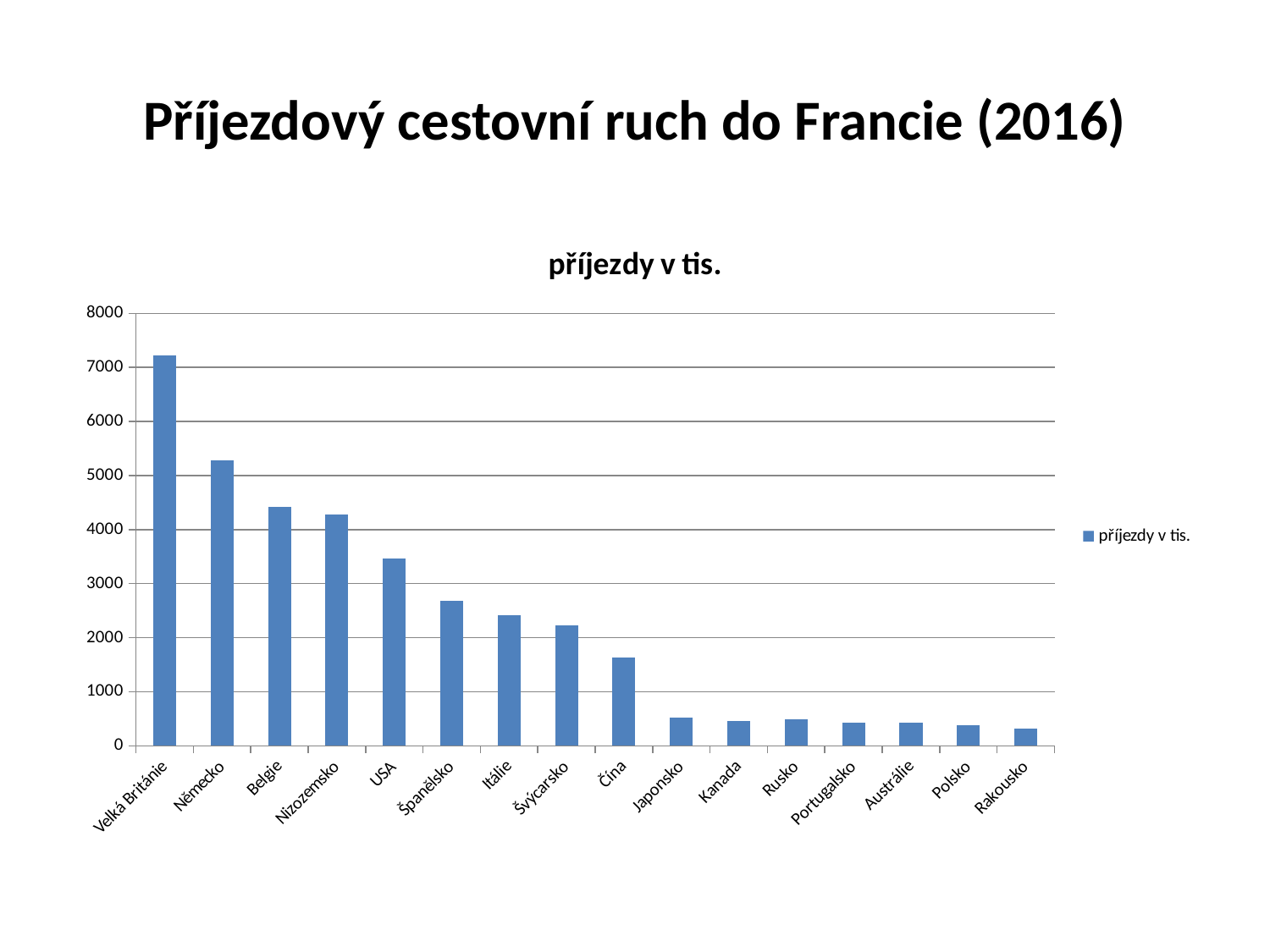
Is the value for USA greater or less than 4000? less Is the value for Velká Británie greater or less than 7000? greater Which has a larger value, Německo or Belgie? Německo Do the values rise or fall moving from left to right along the x axis? fall What is the title of the chart? příjezdy v tis. Which country has the lowest value in the chart? Rakousko What kind of chart is shown on the slide? bar chart How many countries are shown on the x axis of the chart? 16 How many series does the legend list? 1 Is the value for Čína greater or less than 2000? less Which country has the highest value in the chart? Velká Británie